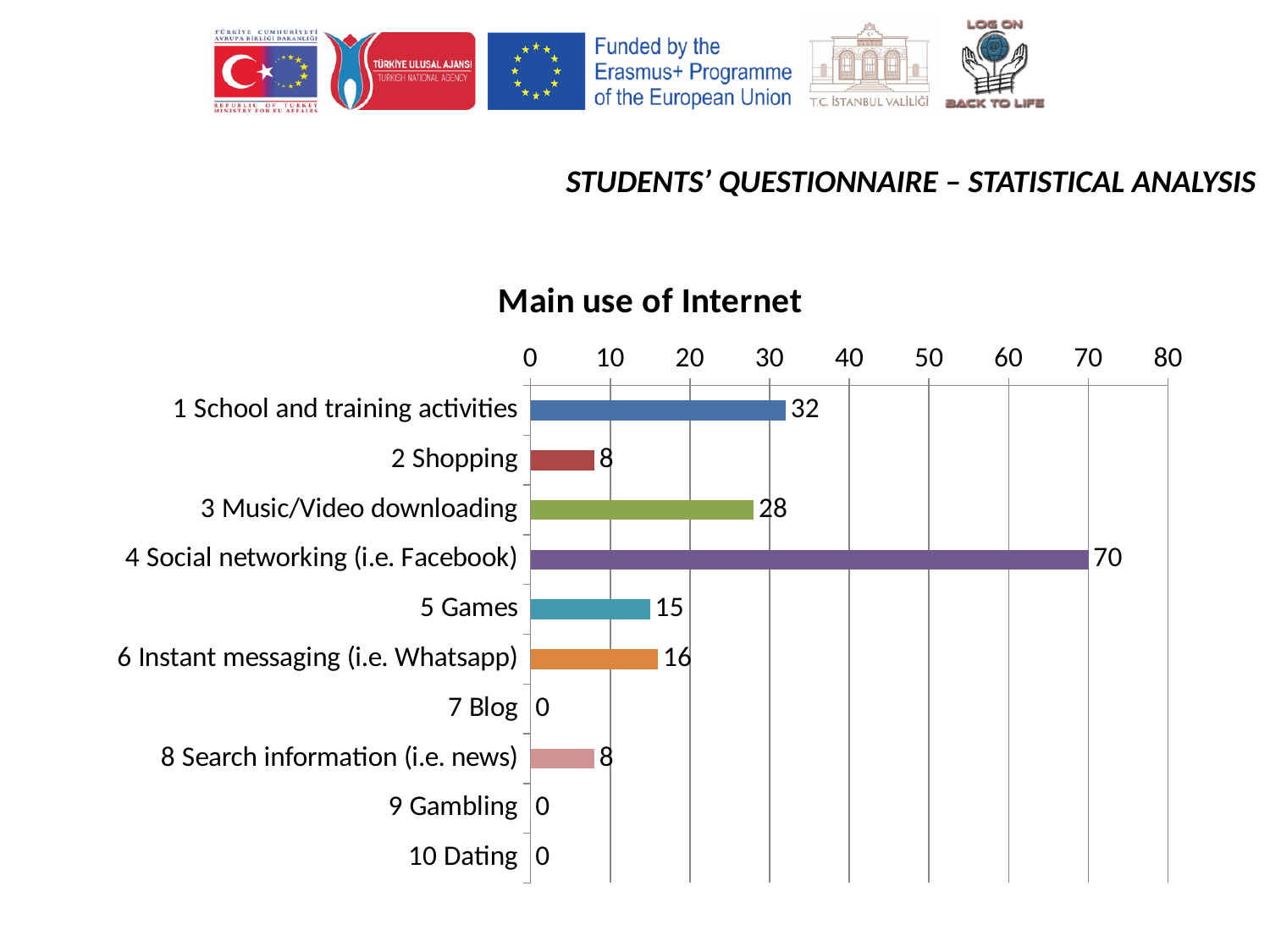
How many categories have a value of 0? 3 How many categories are shown in the chart? 10 Which is larger, the value for Games or the value for Instant messaging (i.e. Whatsapp)? 6 Instant messaging (i.e. Whatsapp) What is the difference between the values for Music/Video downloading and Games? 13 What is the value for School and training activities? 32 What is the title of the chart? Main use of Internet What is the difference between the values for Social networking (i.e. Facebook) and School and training activities? 38 Which is larger, the value for Shopping or the value for Music/Video downloading? 3 Music/Video downloading What kind of chart is shown on the slide? Bar chart What is the value for Instant messaging (i.e. Whatsapp)? 16 Which category has the highest value? 4 Social networking (i.e. Facebook) What is the value for Social networking (i.e. Facebook)? 70